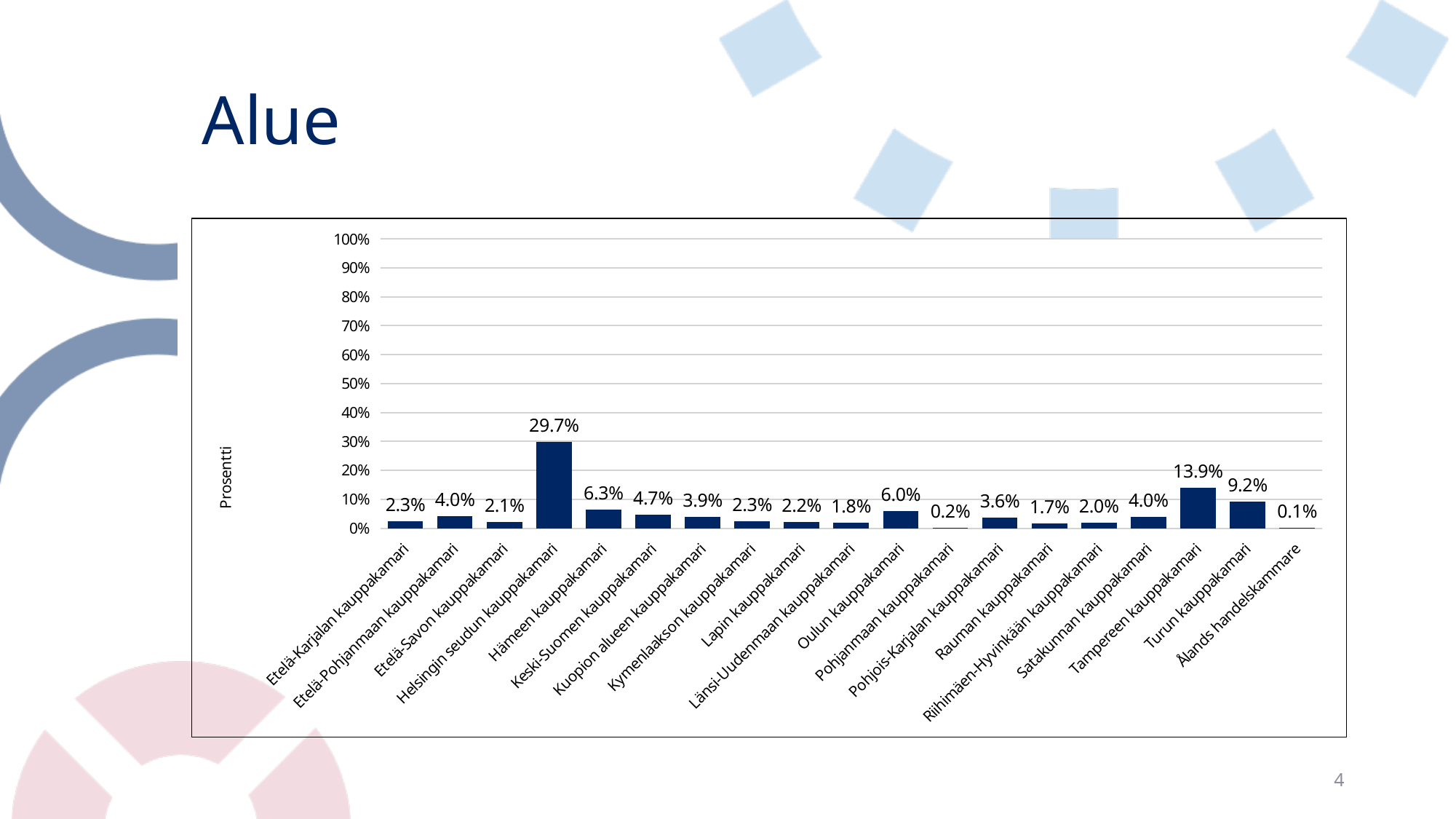
Which category has the lowest value? Ålands handelskammare What is the difference between the values for Tampereen kauppakamari and Turun kauppakamari? 4.7% What kind of chart is shown on the slide? bar chart Which category has the highest value? Helsingin seudun kauppakamari What is the value for Helsingin seudun kauppakamari? 29.7% Is the value for Helsingin seudun kauppakamari greater or less than 20%? greater What is the value for Pohjanmaan kauppakamari? 0.2% What is the value for Tampereen kauppakamari? 13.9% What is the label on the vertical axis of the chart? Prosentti What is the value for Oulun kauppakamari? 6.0% Which is larger, the value for Hämeen kauppakamari or the value for Keski-Suomen kauppakamari? Hämeen kauppakamari How many categories are shown on the x axis? 19